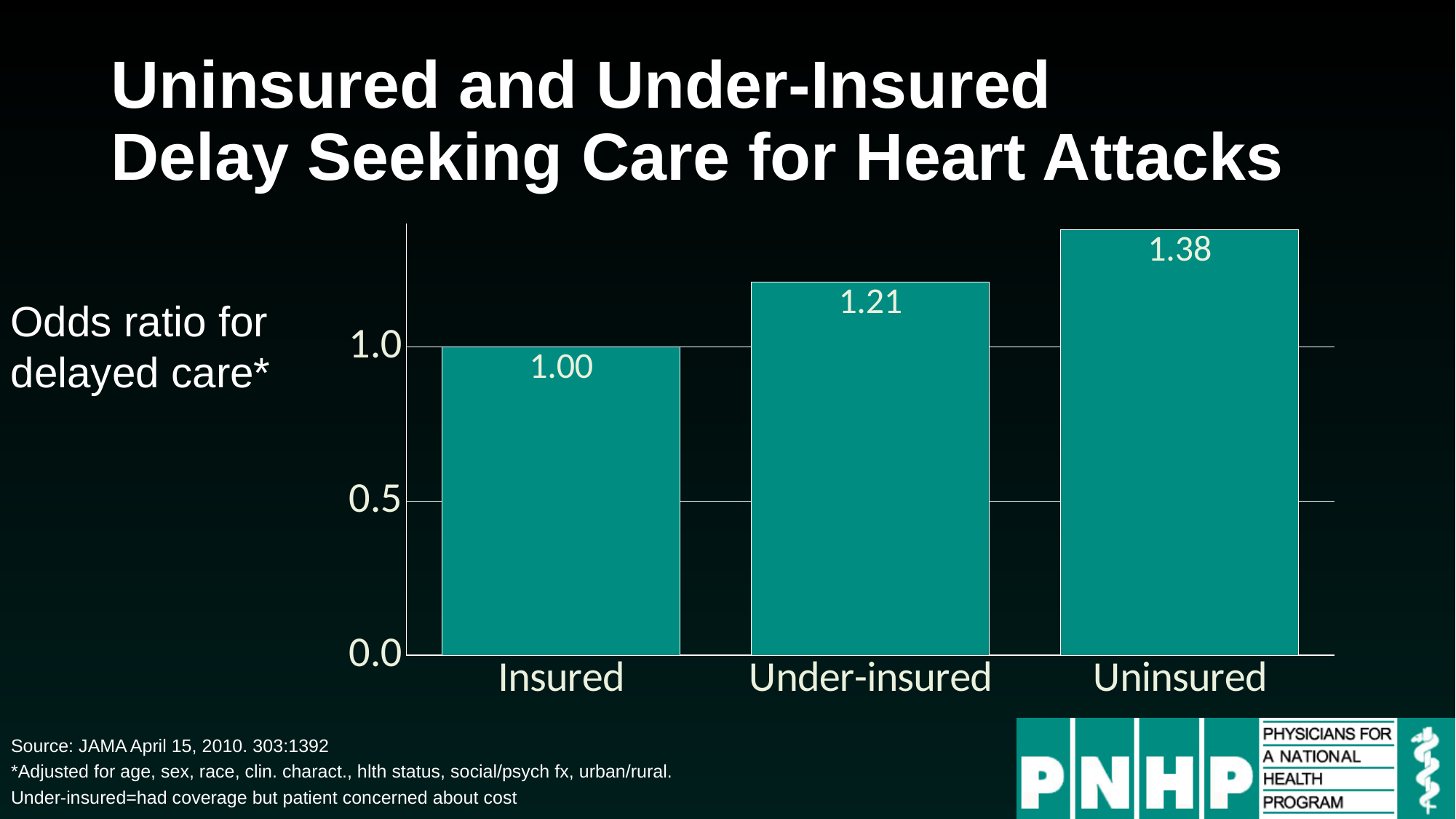
What is the odds ratio for delayed care for the Insured group? 1.00 What is the difference between the odds ratio for the Uninsured group and the Insured group? 0.38 What is the odds ratio for delayed care for the Under-insured group? 1.21 Which group has the highest odds ratio for delayed care? Uninsured What is the difference between the odds ratio for the Uninsured group and the Under-insured group? 0.17 Which group has the lowest odds ratio for delayed care? Insured Which group has a larger odds ratio for delayed care, Under-insured or Uninsured? Uninsured Is the odds ratio for the Under-insured group greater or less than 1.0? greater How many groups are shown on the chart? 3 Do the odds ratios rise or fall moving from Insured to Uninsured along the x axis? Rise What is the odds ratio for delayed care for the Uninsured group? 1.38 What kind of chart is shown on the slide? Bar chart